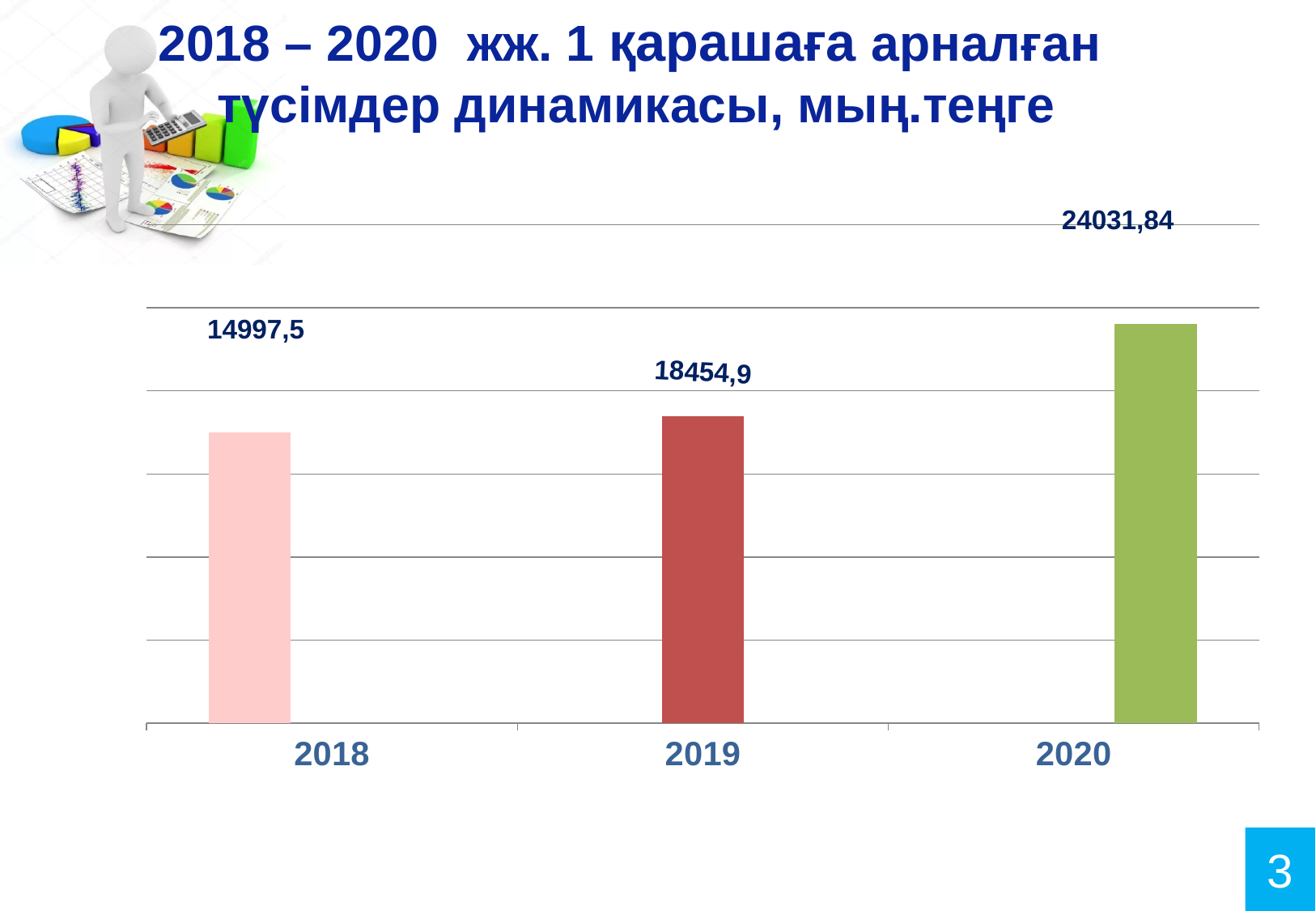
What kind of chart is shown on the slide? Bar chart Which year has the highest value? 2020 How many years are shown on the x axis? 3 What is the value shown for 2020? 24031,84 Which is larger, the value for 2019 or the value for 2020? 2020 What is the value shown for 2019? 18454,9 Which year has the lowest value? 2018 What is the difference between the values for 2020 and 2019? 5576,94 What is the value shown for 2018? 14997,5 What is the difference between the values for 2019 and 2018? 3457,4 Do the values rise or fall from 2018 to 2020? Rise What colour is the bar for 2020? Green